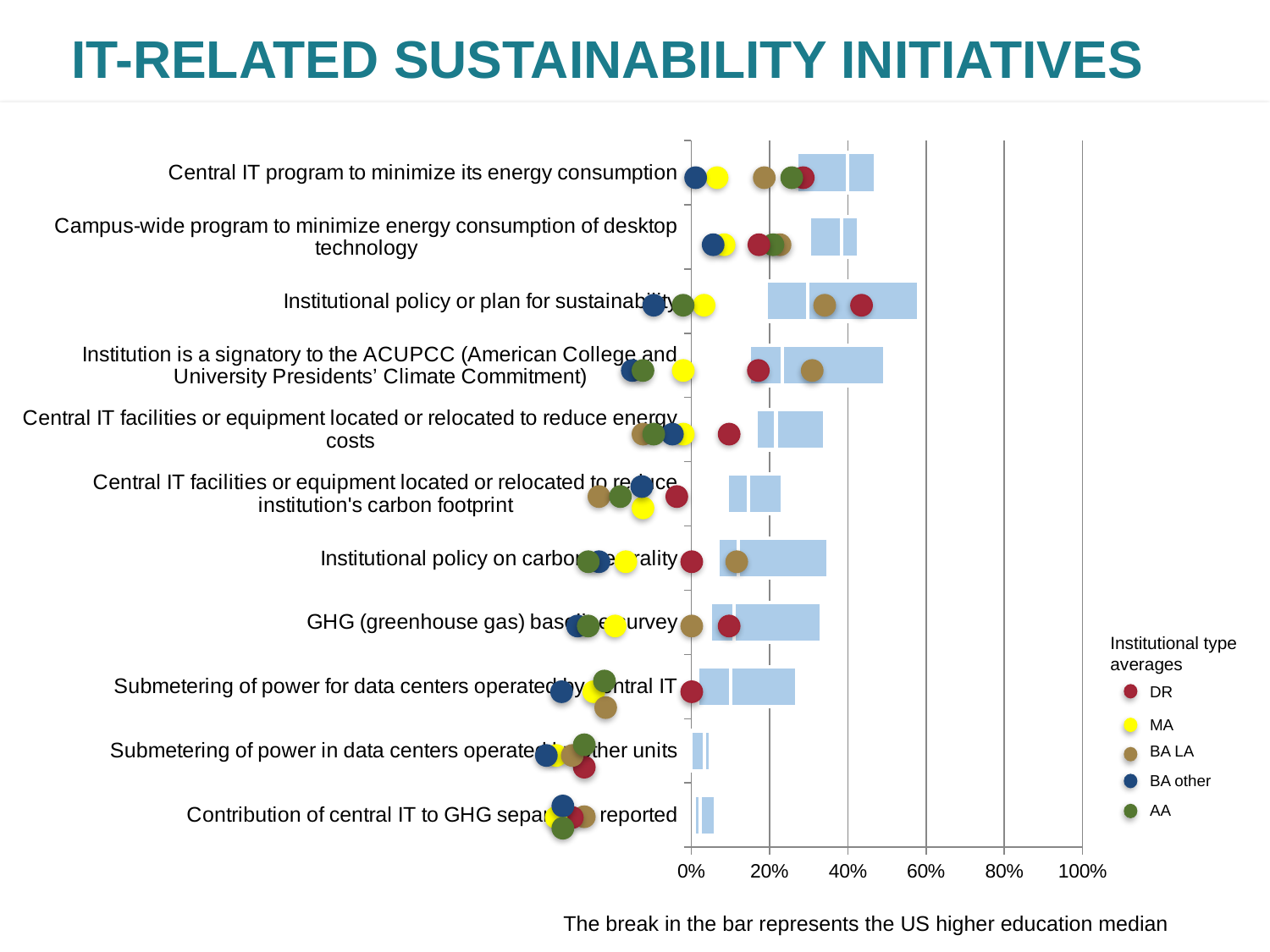
Is the DR average for 'Central IT facilities or equipment located or relocated to reduce energy costs' greater or less than 20%? less What kind of chart is shown on the slide? bar chart For 'Institutional policy or plan for sustainability', which is larger: the DR average or the MA average? DR According to the note below the chart, what does the break in each bar represent? The US higher education median How many IT-related sustainability initiatives (categories) are listed on the chart? 11 Is the right end of the bar for 'Central IT program to minimize its energy consumption' greater or less than 40%? greater Is the right end of the bar for 'Institutional policy or plan for sustainability' greater or less than 60%? less Which initiative has the bar that extends furthest to the right on the chart? Institutional policy or plan for sustainability What is the title of the slide? IT-RELATED SUSTAINABILITY INITIATIVES How many institutional types does the legend list? 5